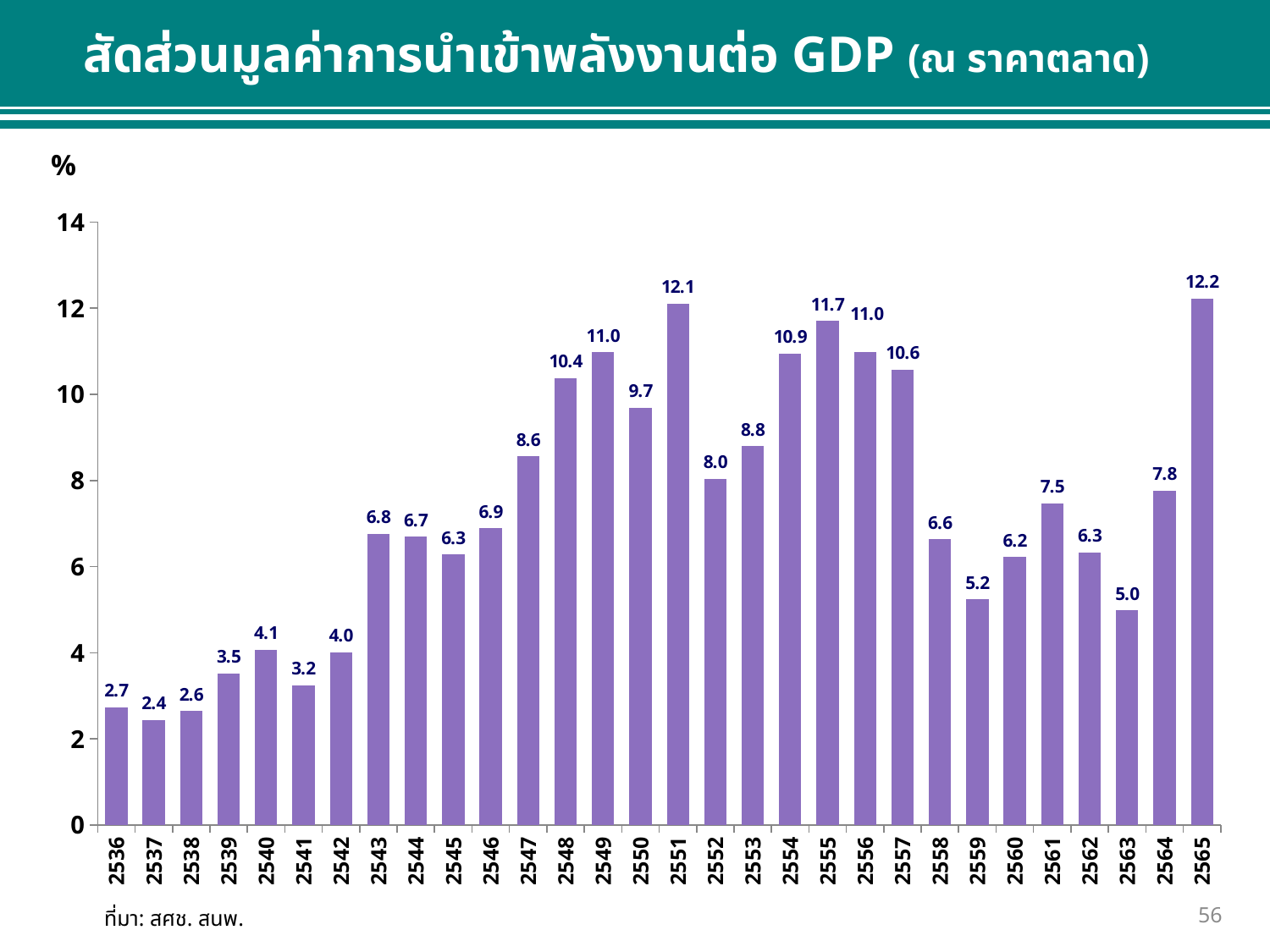
What is the value for 2563? 5.0 What is the difference between the values for 2565 and 2564? 4.4 Is the value for 2550 greater or less than 8? greater What is the value for 2551? 12.1 What is the value for 2548? 10.4 Do the values rise or fall from 2536 to 2551? Rise Which year has the lowest value? 2537 What is the difference between the values for 2555 and 2558? 5.1 Which year has the highest value? 2565 How many years are shown on the x axis? 30 Which is larger, the value for 2547 or the value for 2553? 2553 What kind of chart is shown on the slide? Bar chart